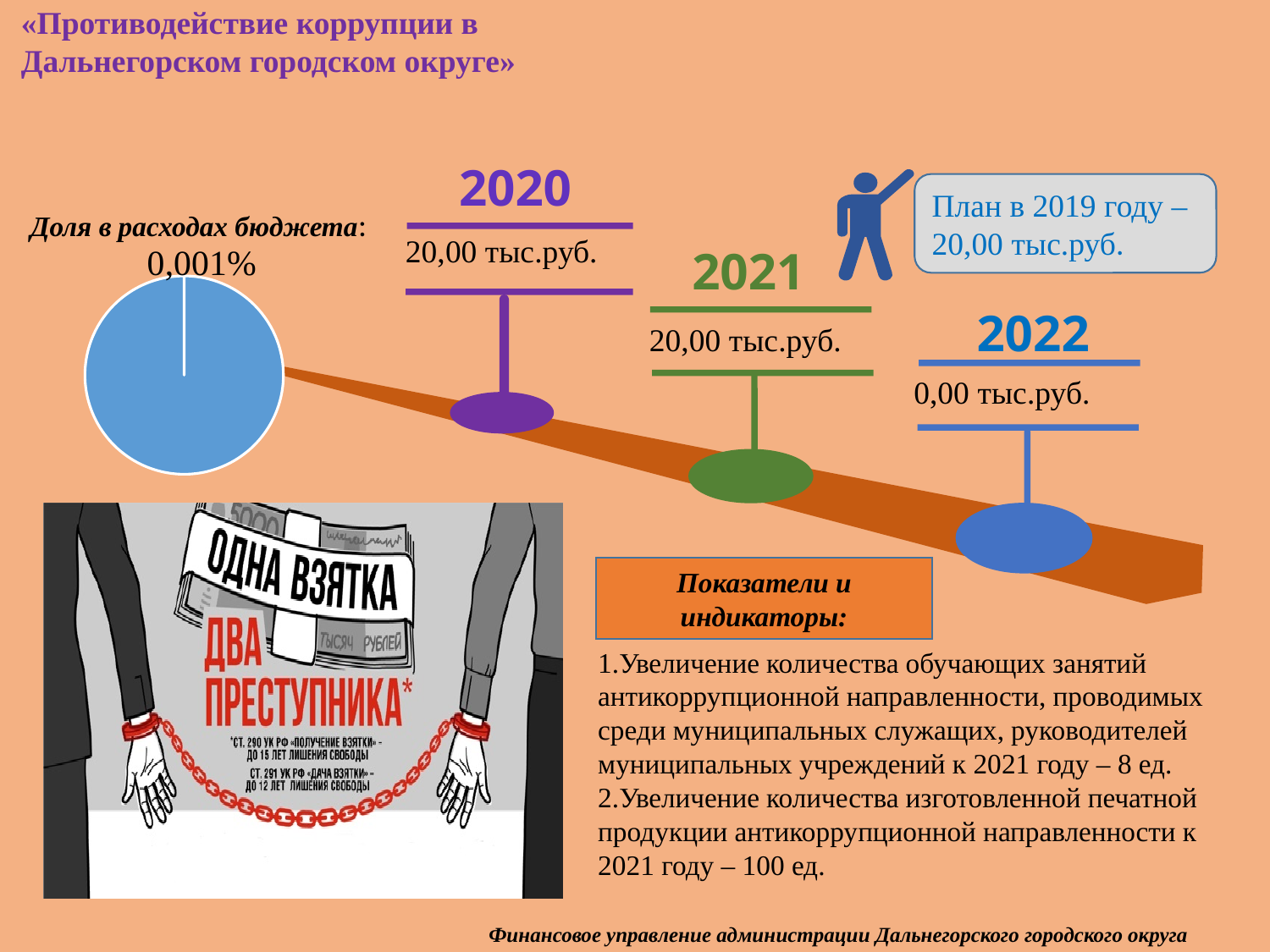
What colour is the pie chart on the slide? blue What is the label (title) of the pie chart on the slide? Доля в расходах бюджета What kind of chart is shown on the slide next to the label «Доля в расходах бюджета»? pie chart What value is printed above the pie chart for «Доля в расходах бюджета»? 0,001%